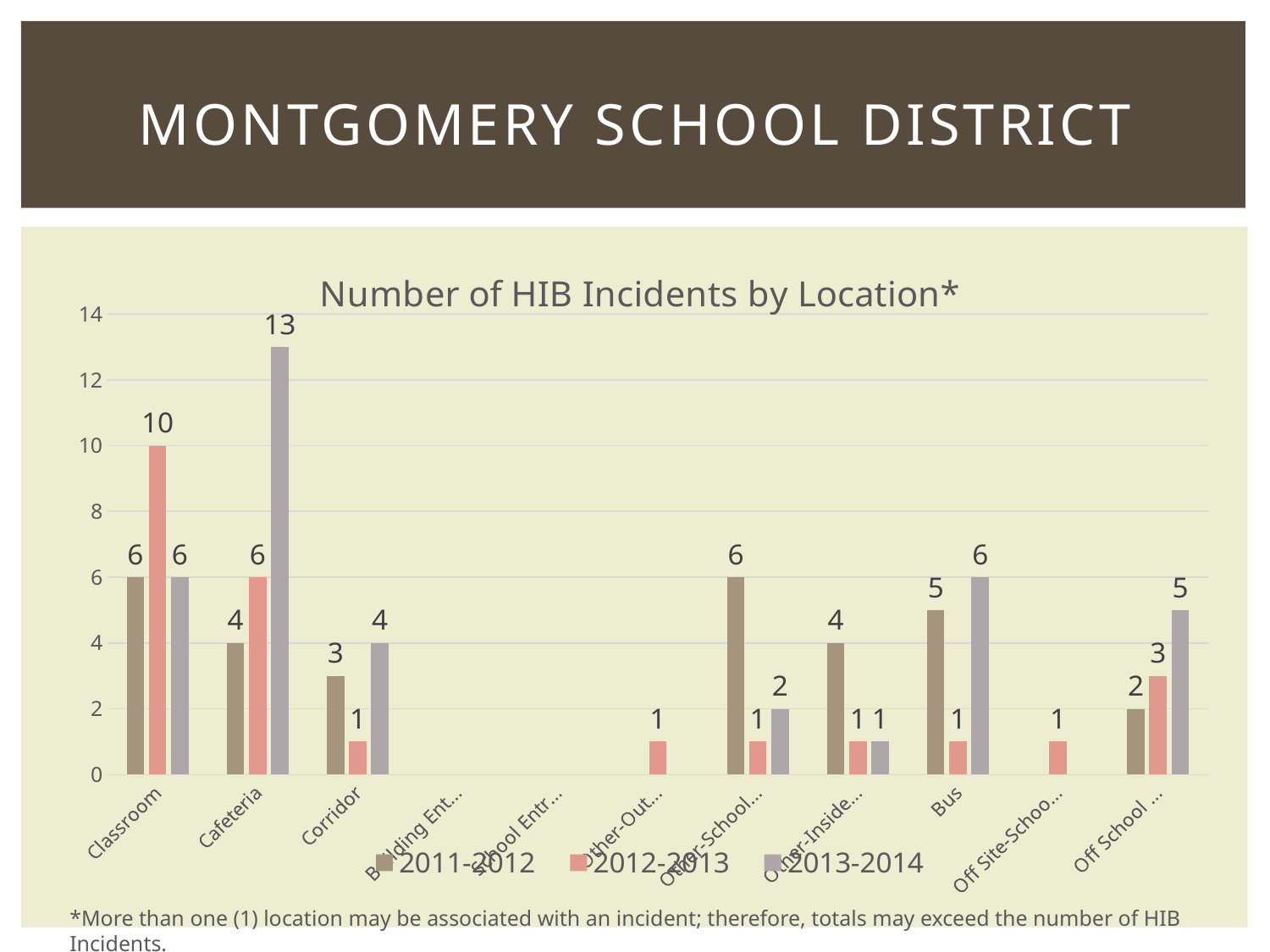
Which is larger for Bus: the 2011-2012 value or the 2012-2013 value? 2011-2012 What is the value for Corridor in the 2011-2012 series? 3 What is the title of the chart? Number of HIB Incidents by Location* How many series does the legend list? 3 What is the value for Cafeteria in the 2013-2014 series? 13 What is the difference between the 2013-2014 and 2011-2012 values for Cafeteria? 9 Which location has the highest value in the 2013-2014 series? Cafeteria What type of chart is shown on the slide? bar chart What is the value for Bus in the 2013-2014 series? 6 Which location has the highest value in the 2012-2013 series? Classroom What is the difference between the 2012-2013 and 2011-2012 values for Classroom? 4 What is the value for Classroom in the 2012-2013 series? 10